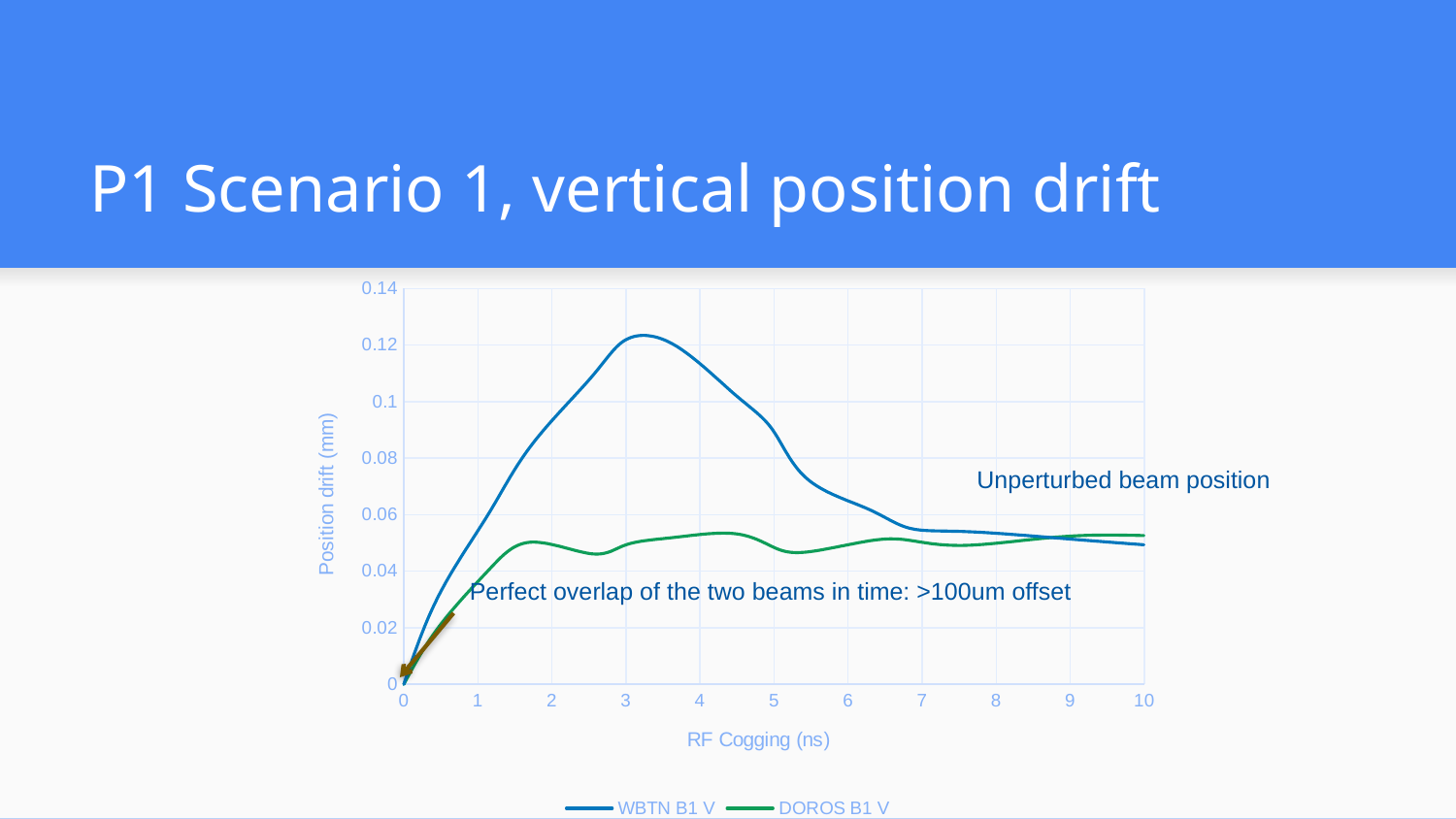
What are the two series named in the legend? WBTN B1 V and DOROS B1 V Is the value of DOROS B1 V at RF Cogging 3 ns greater or less than 0.06? less Is the value of WBTN B1 V at RF Cogging 3 ns greater or less than 0.1? greater What is the label of the x axis? RF Cogging (ns) At RF Cogging 3 ns, which series has the larger position drift, WBTN B1 V or DOROS B1 V? WBTN B1 V Is the value of WBTN B1 V at RF Cogging 5 ns greater or less than 0.08? greater How many series does the legend list? 2 What kind of chart is shown on the slide? line chart Does the WBTN B1 V series rise or fall between RF Cogging 4 ns and 10 ns? fall Does the DOROS B1 V series rise or fall between RF Cogging 0 ns and 1 ns? rise